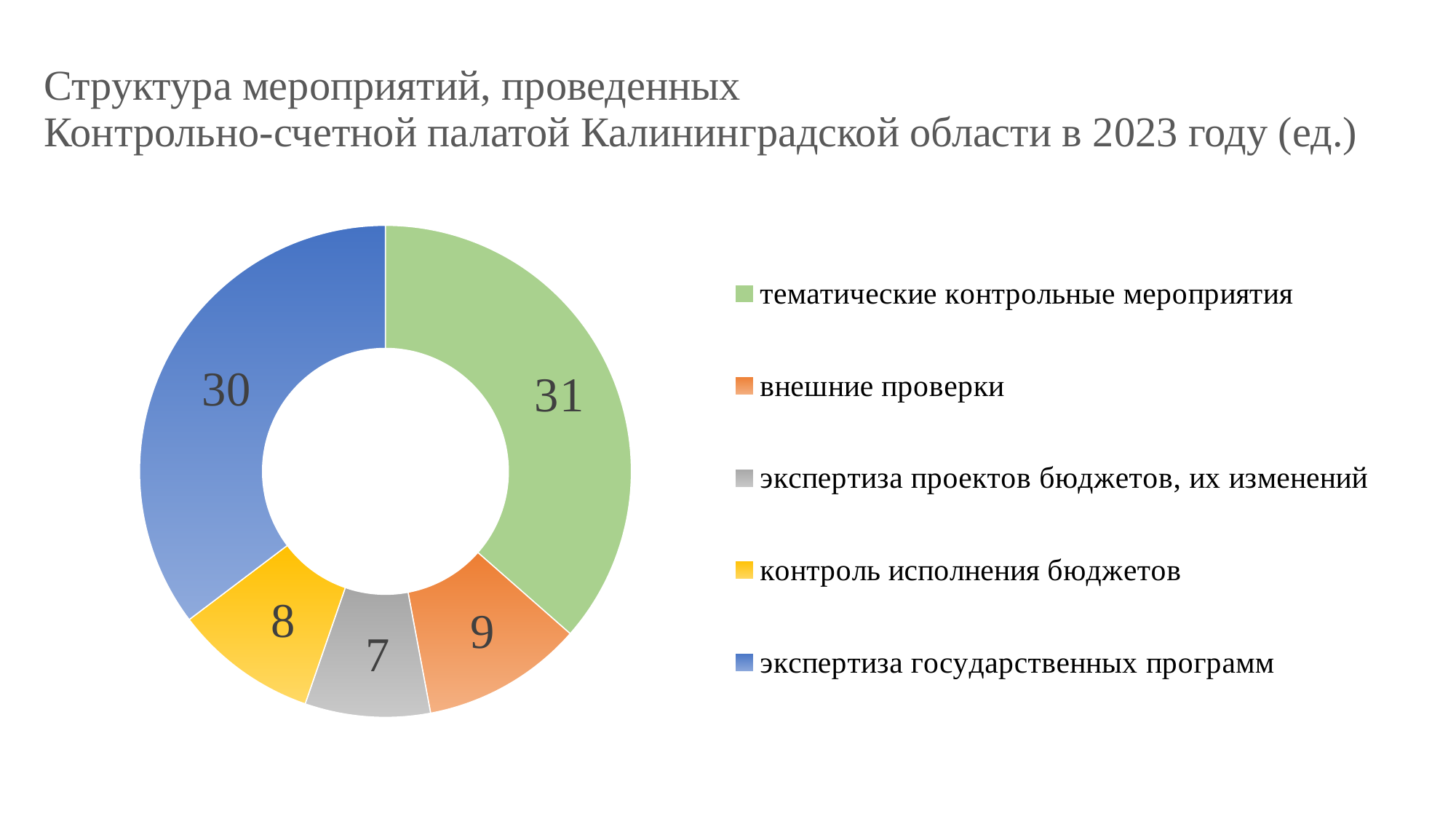
What is the value for "контроль исполнения бюджетов"? 8 What is the value for "экспертиза проектов бюджетов, их изменений"? 7 Which category has the lowest value? экспертиза проектов бюджетов, их изменений What is the value for "экспертиза государственных программ"? 30 How many categories does the chart show? 5 What is the value for "внешние проверки"? 9 What is the value for "тематические контрольные мероприятия"? 31 What is the difference between the values for "тематические контрольные мероприятия" and "экспертиза государственных программ"? 1 Which is larger: the value for "внешние проверки" or the value for "контроль исполнения бюджетов"? внешние проверки Which category has the highest value? тематические контрольные мероприятия What type of chart is shown on the slide? Doughnut (pie) chart What colour represents "экспертиза государственных программ" in the chart? Blue